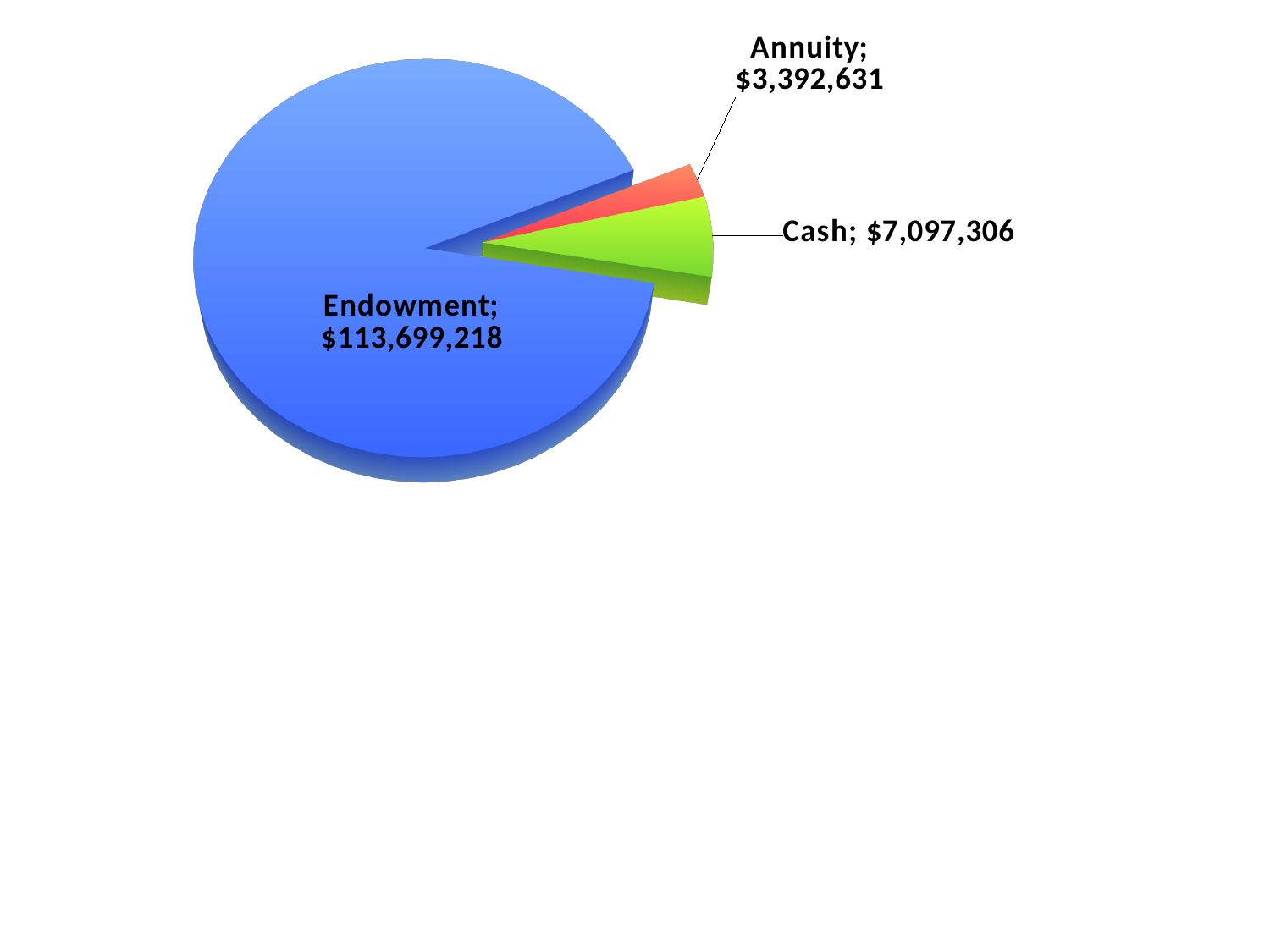
What is the value of the Cash slice? $7,097,306 What colour is the Endowment slice? Blue Which category has the largest value? Endowment Which category has the smallest value? Annuity What is the total of all three slices? $124,189,155 What is the difference between the Cash and Annuity values? $3,704,675 How many slices does the pie chart have? 3 What is the value of the Endowment slice? $113,699,218 Which is larger, Cash or Annuity? Cash What is the difference between the Endowment and Cash values? $106,601,912 What is the value of the Annuity slice? $3,392,631 What kind of chart is shown on the slide? Pie chart